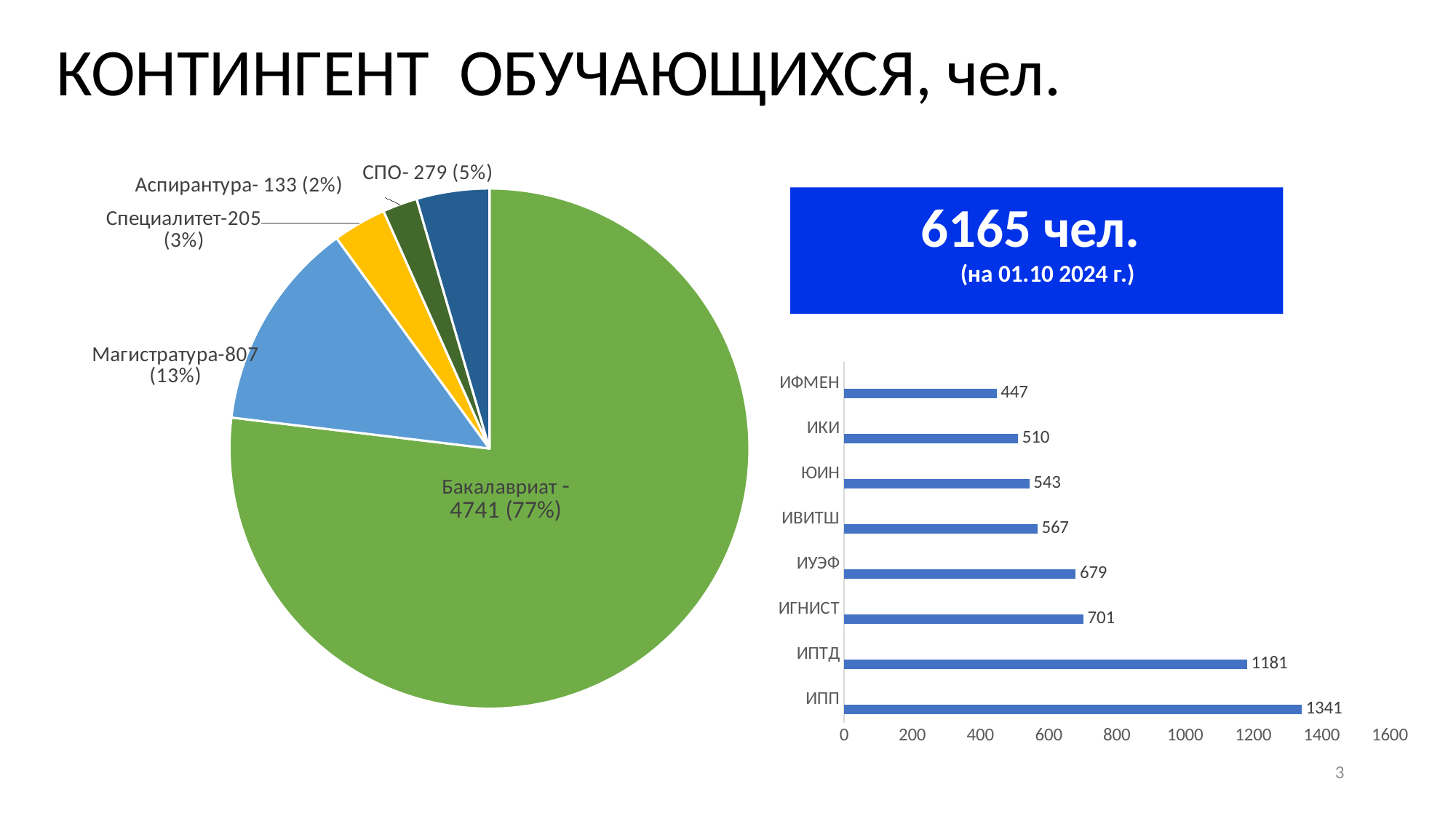
In the pie chart on the left, which is larger: СПО or Специалитет? СПО In the pie chart on the left, what share of the pie does Магистратура take? 13% In the bar chart on the right, which category has the lowest value? ИФМЕН In the bar chart on the right, how many categories are shown? 8 In the bar chart on the right, what is the value for ИУЭФ? 679 In the pie chart on the left, how many slices are there? 5 In the bar chart on the right, which category has the highest value? ИПП In the bar chart on the right, what is the difference between ИПП and ИПТД? 160 In the pie chart on the left, which category has the smallest slice? Аспирантура What kind of chart is shown on the right side of the slide? bar chart In the pie chart on the left, what is the value for Бакалавриат? 4741 (77%) In the bar chart on the right, is the value for ИГНИСТ greater or less than 800? less